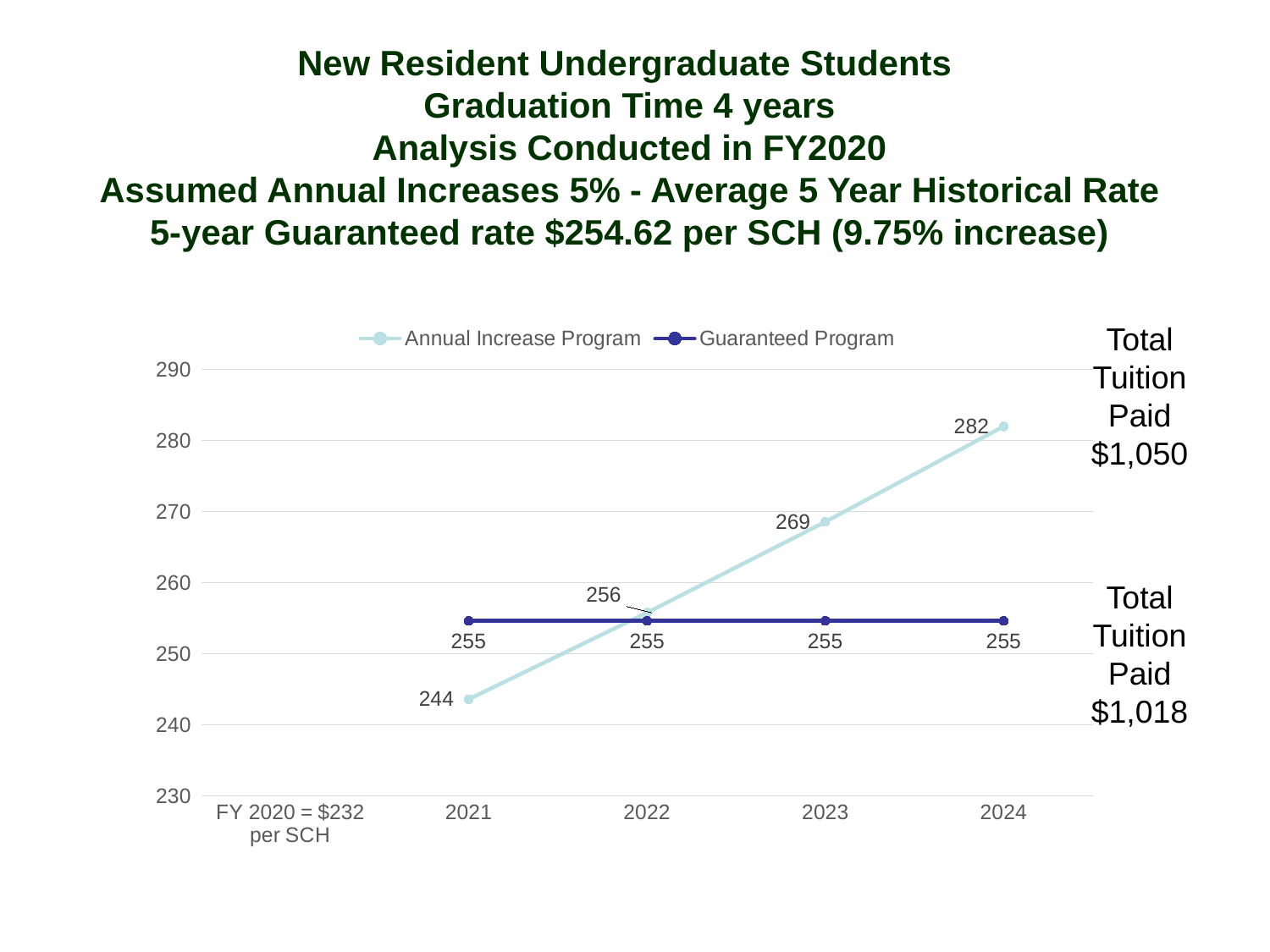
What is the difference between the Annual Increase Program value in 2024 and in 2021? 38 What is the value of the Guaranteed Program in 2023? 255 In which year is the Annual Increase Program value lowest? 2021 What type of chart is shown on the slide? line chart What is the value of the Annual Increase Program in 2021? 244 What total tuition paid is shown for the Annual Increase Program? $1,050 In which year is the Annual Increase Program value highest? 2024 Which series has the larger value in 2021, Annual Increase Program or Guaranteed Program? Guaranteed Program Does the Annual Increase Program rise or fall from 2021 to 2024? rise What is the value of the Annual Increase Program in 2024? 282 How many data points are plotted for the Guaranteed Program series? 4 How many series does the chart legend list? 2